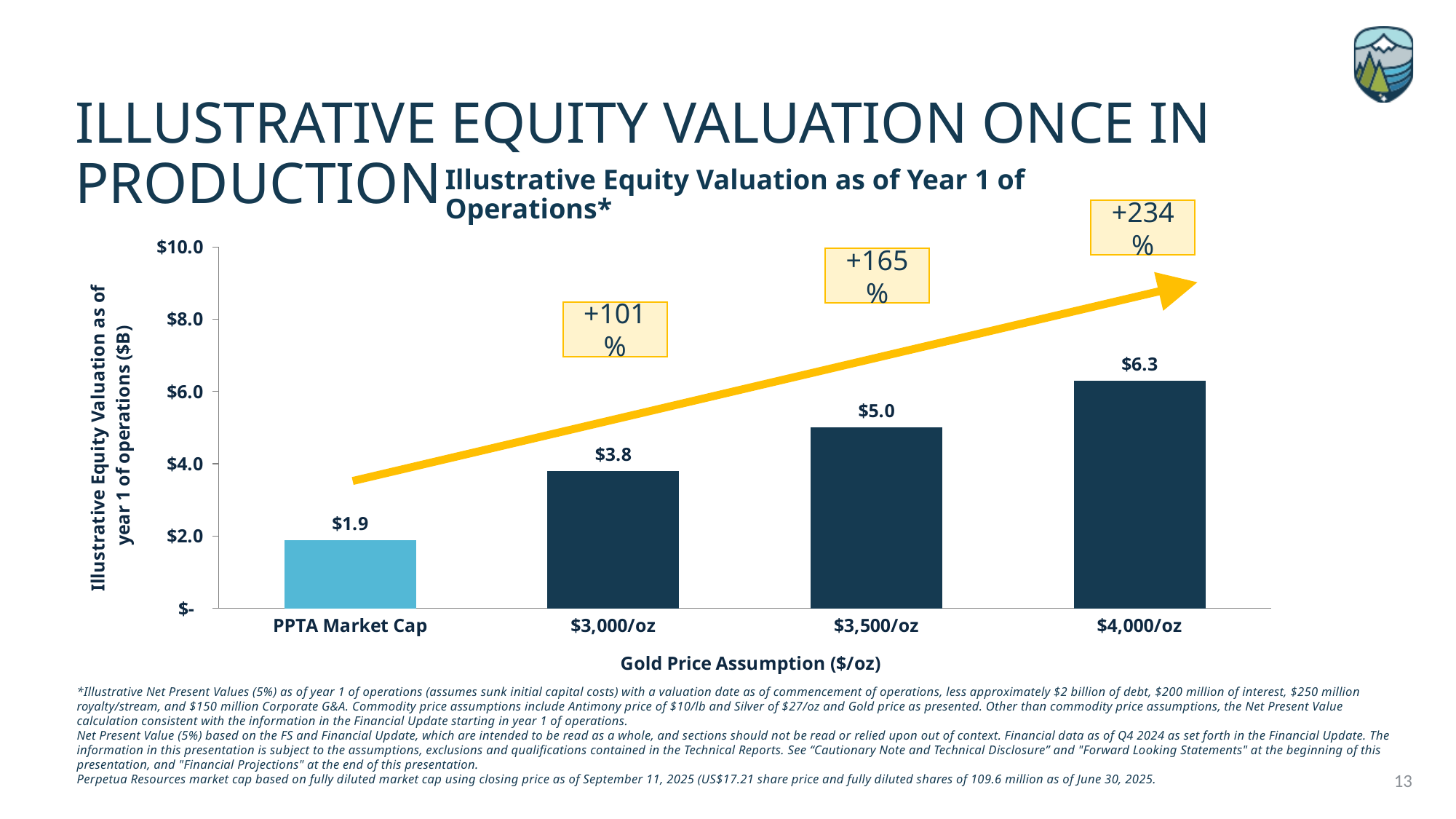
How many bars are shown in the chart? 4 What is the illustrative equity valuation at the $3,000/oz gold price assumption? $3.8 What kind of chart is shown on the slide? Bar chart What is the illustrative equity valuation at $4,000/oz? $6.3 Which is larger, the value at $3,500/oz or the value at $3,000/oz? $3,500/oz What is the label of the x axis? Gold Price Assumption ($/oz) Is the value at $3,500/oz greater or less than $4.0? greater Do the values rise or fall from left to right across the categories? Rise What is the value shown for PPTA Market Cap? $1.9 What is the difference between the $4,000/oz value and the PPTA Market Cap value? $4.4 Which category has the lowest value? PPTA Market Cap Which category has the highest value? $4,000/oz